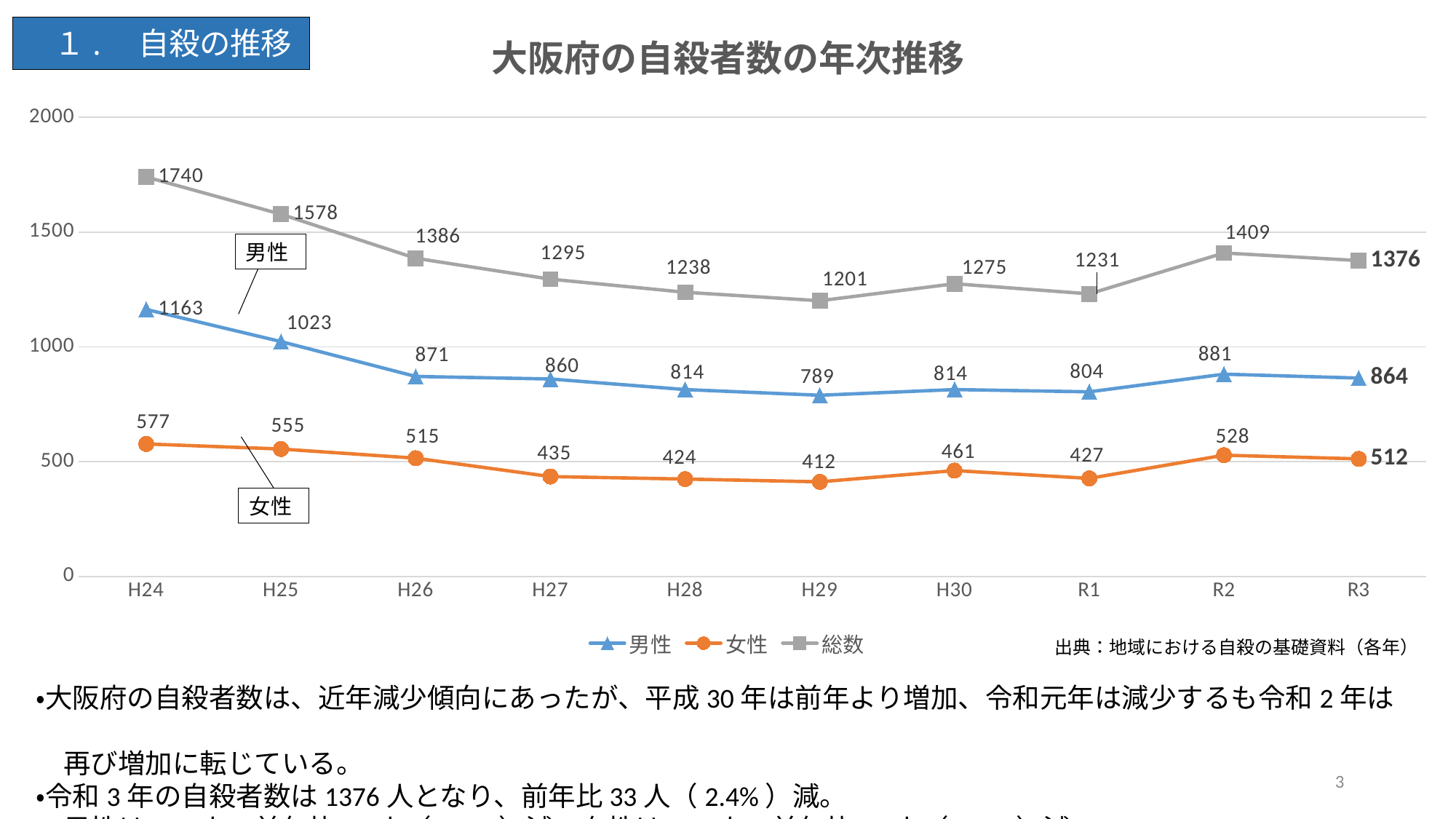
What kind of chart is this? line chart What is the value of 男性 for R3? 864 How many series does the legend list? 3 Does 総数 rise or fall from H24 to H29? fall What is the difference between 総数 for R2 and R3? 33 In which year is 男性 highest? H24 How many years are shown on the x axis? 10 In which year is 総数 lowest? H29 What is the title of the chart? 大阪府の自殺者数の年次推移 Which is larger, 女性 for H30 or 女性 for R1? H30 What is the value of 総数 for H24? 1740 What is the value of 女性 for H29? 412